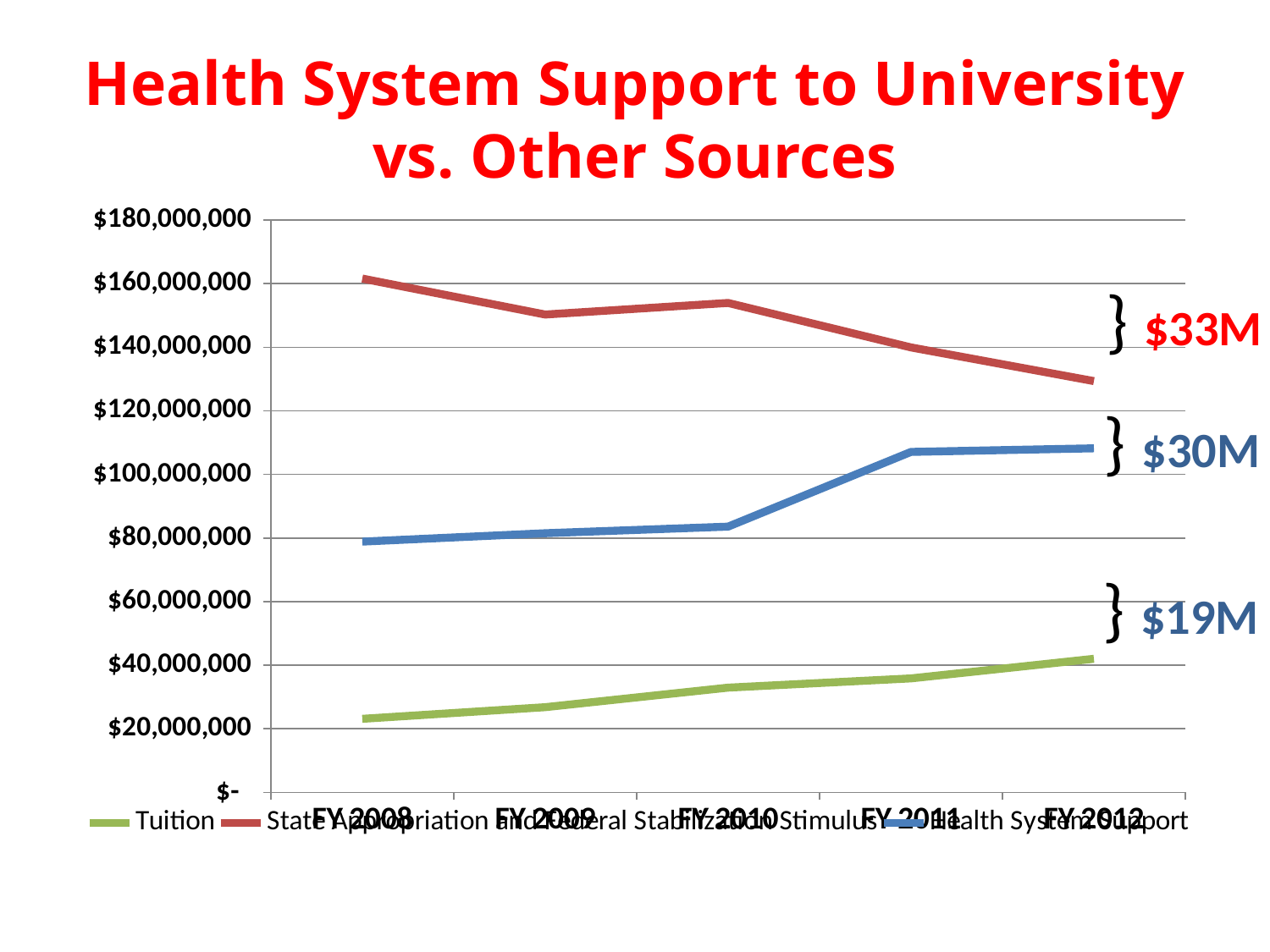
How many series does the legend list? 3 What annotation is shown to the right of the Health System Support line? $30M Does the Tuition line rise or fall from FY 2008 to FY 2012? rise In FY 2012, which is larger: Health System Support or Tuition? Health System Support Is the State Appropriation and Federal Stabilization Stimulus value for FY 2012 greater or less than $140,000,000? less Does the State Appropriation and Federal Stabilization Stimulus line rise or fall from FY 2008 to FY 2012? fall Does the Health System Support line rise or fall from FY 2008 to FY 2012? rise What kind of chart is shown on the slide? line chart Which series has the highest value in FY 2008? State Appropriation and Federal Stabilization Stimulus Which series has the lowest value in FY 2012? Tuition Is the Health System Support value for FY 2012 greater or less than $100,000,000? greater How many fiscal years are plotted along the x axis? 5